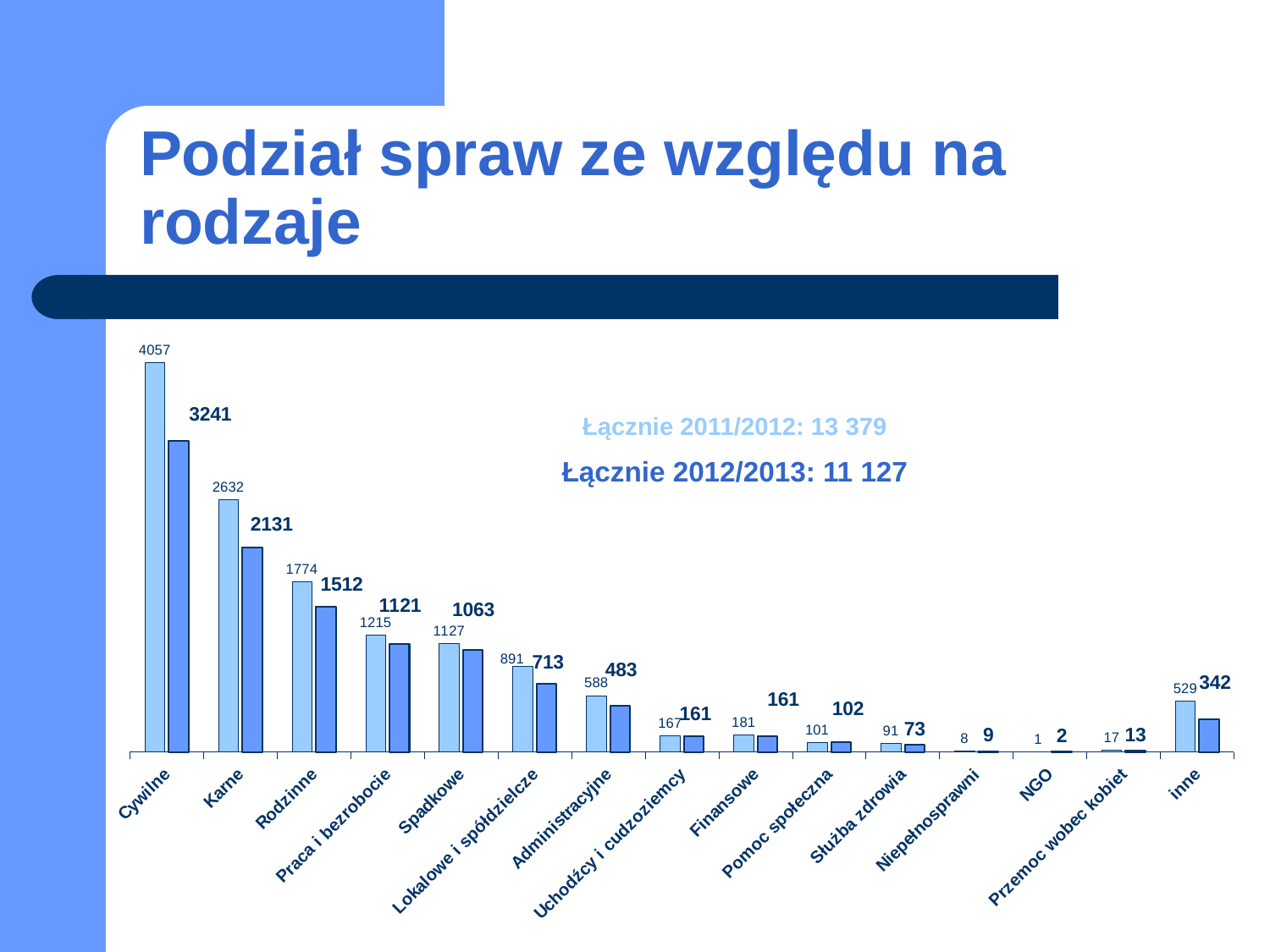
Which is larger: the light blue bar for Spadkowe or the light blue bar for Lokalowe i spółdzielcze? Spadkowe What is the value of the dark blue bar for Karne? 2131 What type of chart is shown on the slide? bar chart What is the difference between the light blue and dark blue bars for Cywilne? 816 What is the value of the light blue bar for inne? 529 How many categories are shown along the x axis of the chart? 15 Do the light blue bars generally rise or fall from Cywilne to Administracyjne along the x axis? fall What is the value of the light blue bar for Cywilne? 4057 Which category has the highest light blue bar? Cywilne What is the value of the dark blue bar for Rodzinne? 1512 What total is given on the slide for 2012/2013? 11 127 Which category has the lowest light blue bar? NGO